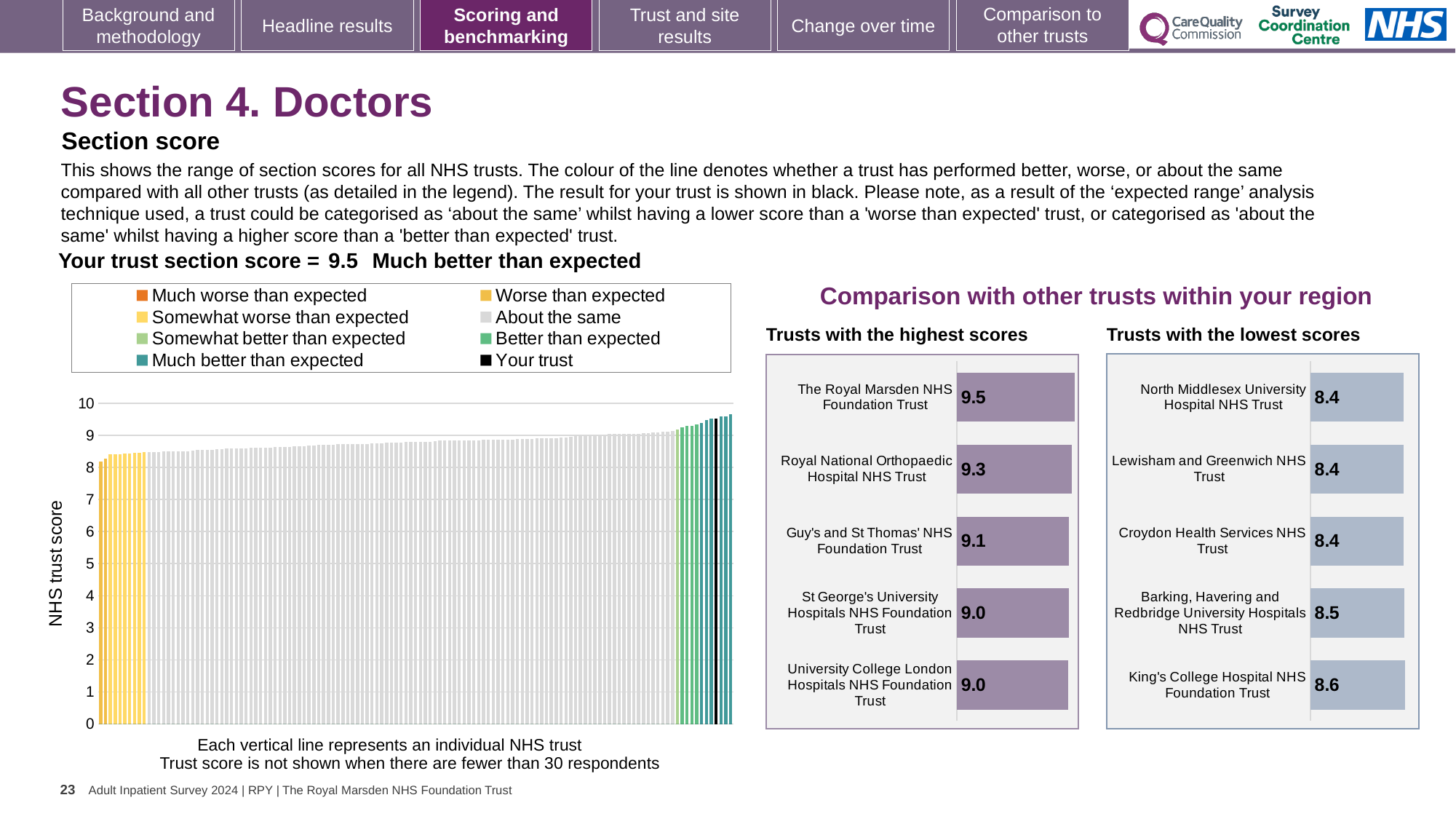
In the 'Trusts with the lowest scores' chart, which has the larger score: Barking, Havering and Redbridge University Hospitals NHS Trust or Croydon Health Services NHS Trust? Barking, Havering and Redbridge University Hospitals NHS Trust In the large chart on the left, is the value of the black bar (your trust) greater or less than 9? greater In the 'Trusts with the highest scores' chart, which trust has the highest score? The Royal Marsden NHS Foundation Trust What kind of chart is the large chart on the left showing the range of section scores for all NHS trusts? bar chart In the 'Trusts with the lowest scores' chart, what is the score for King's College Hospital NHS Foundation Trust? 8.6 In the 'Trusts with the lowest scores' chart, which trust has the highest score shown? King's College Hospital NHS Foundation Trust In the 'Trusts with the highest scores' chart, what is the difference between the scores of The Royal Marsden NHS Foundation Trust and Guy's and St Thomas' NHS Foundation Trust? 0.4 In the large chart on the left, do the bar values rise or fall from left to right along the x axis? rise How many trusts are listed in the 'Trusts with the highest scores' chart? 5 How many entries does the legend of the large chart on the left list? 8 What is the y-axis label of the large chart on the left? NHS trust score In the 'Trusts with the highest scores' chart, what is the score for Royal National Orthopaedic Hospital NHS Trust? 9.3